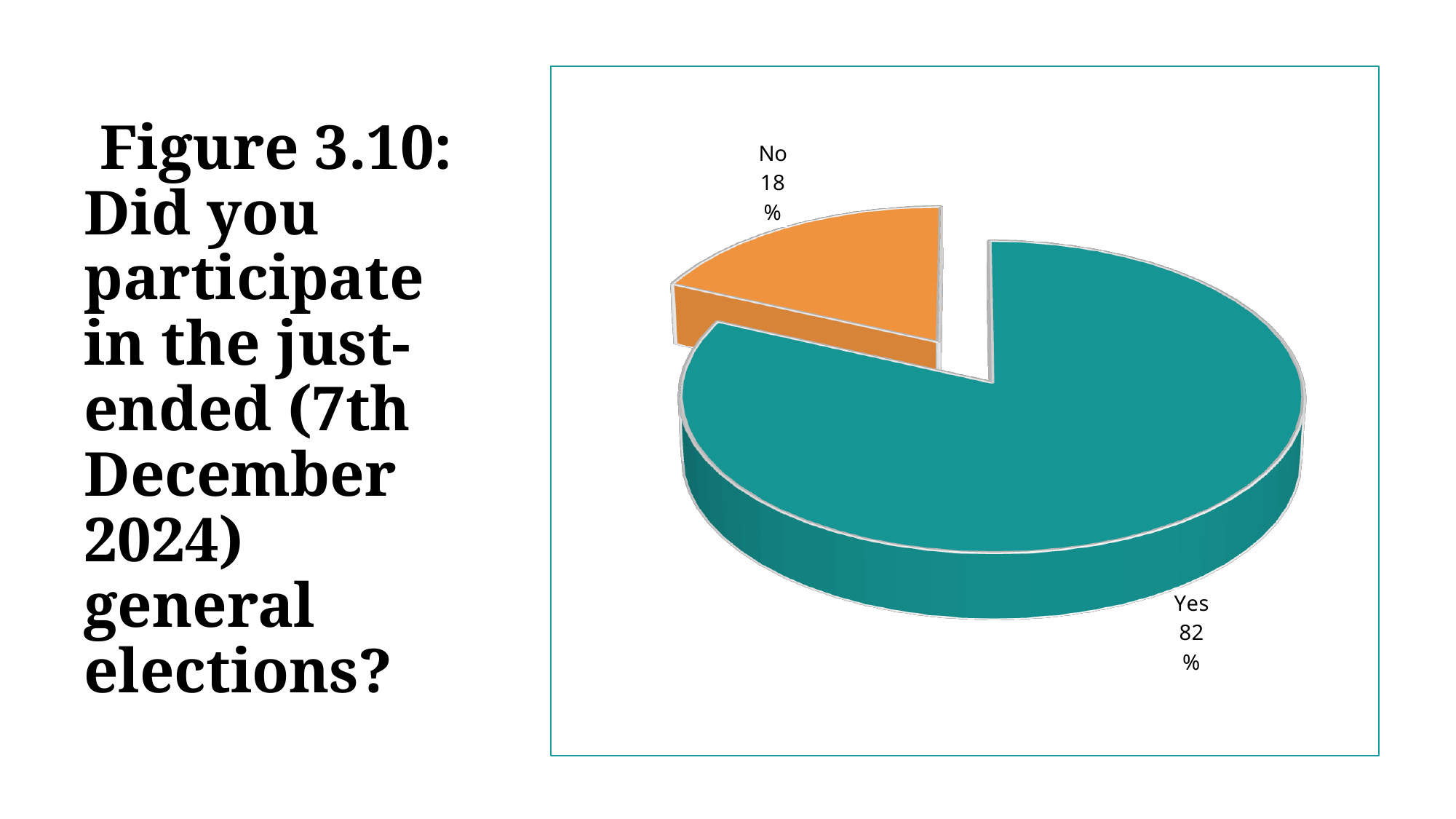
What colour is the Yes slice? Teal What kind of chart is shown on the slide? Pie chart Which response has the largest share of the pie? Yes What share of the pie does the No slice represent? 18% What percentage of respondents answered Yes? 82% Which response has the smallest share of the pie? No What is the difference in percentage points between the Yes and No slices? 64 How many slices does the pie chart have? 2 What is the figure number given in the slide title? Figure 3.10 Which slice is larger, Yes or No? Yes What percentage of respondents answered No? 18%